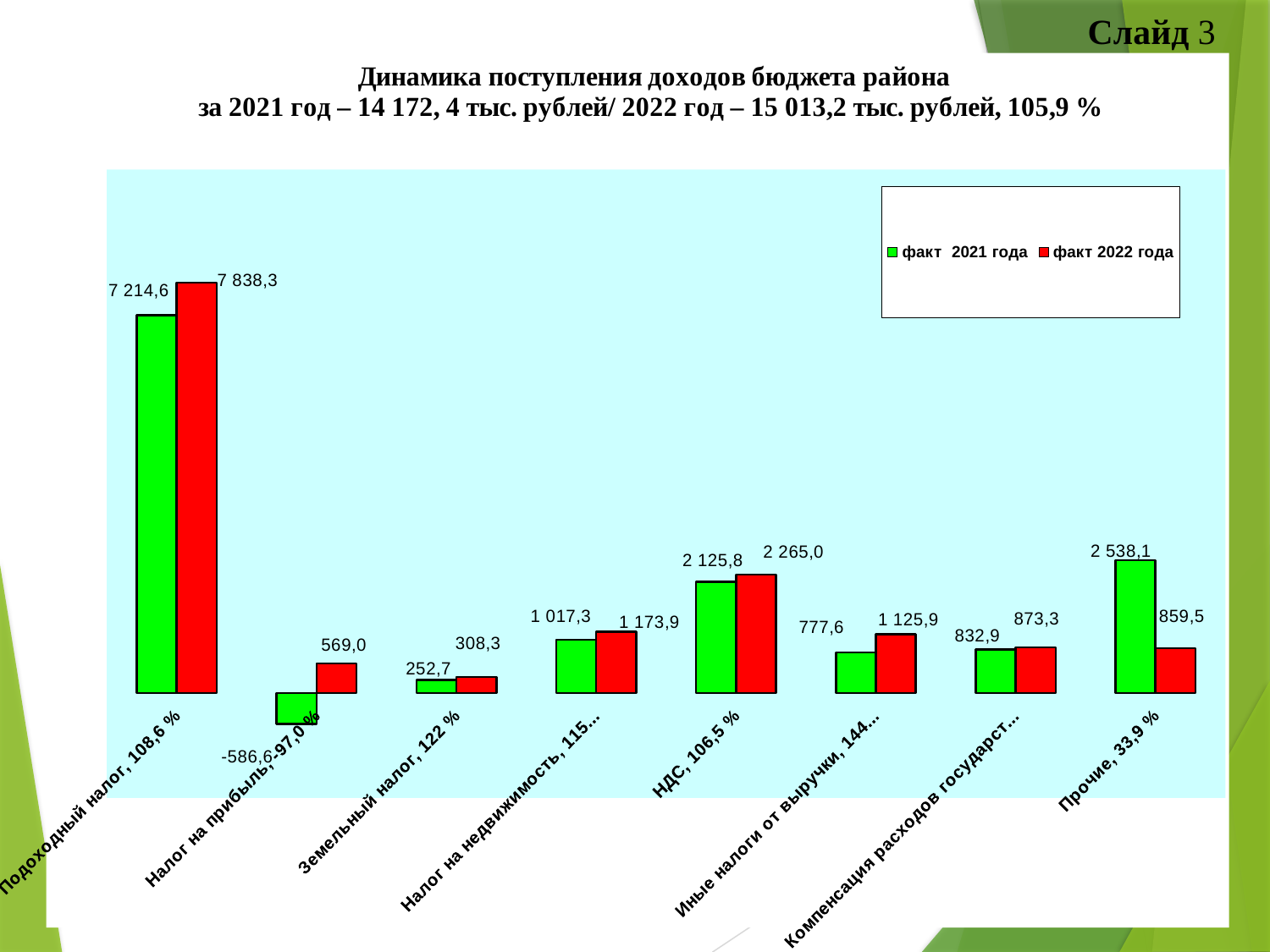
How many series does the legend list? 2 Which category has the highest факт 2022 года value? Подоходный налог What is the difference between the факт 2022 года and факт 2021 года values for Подоходный налог? 623,7 Which category has the lowest факт 2021 года value? Налог на прибыль What is the факт 2022 года value for НДС? 2 265,0 What is the difference between the факт 2021 года and факт 2022 года values for Прочие? 1 678,6 What is the факт 2021 года value for Подоходный налог? 7 214,6 What is the факт 2022 года value for Прочие? 859,5 What is the факт 2021 года value for Налог на прибыль? -586,6 How many categories are shown on the x axis of the chart? 8 Which category has the lowest факт 2022 года value? Земельный налог For Иные налоги от выручки, which is larger: the факт 2021 года value or the факт 2022 года value? факт 2022 года